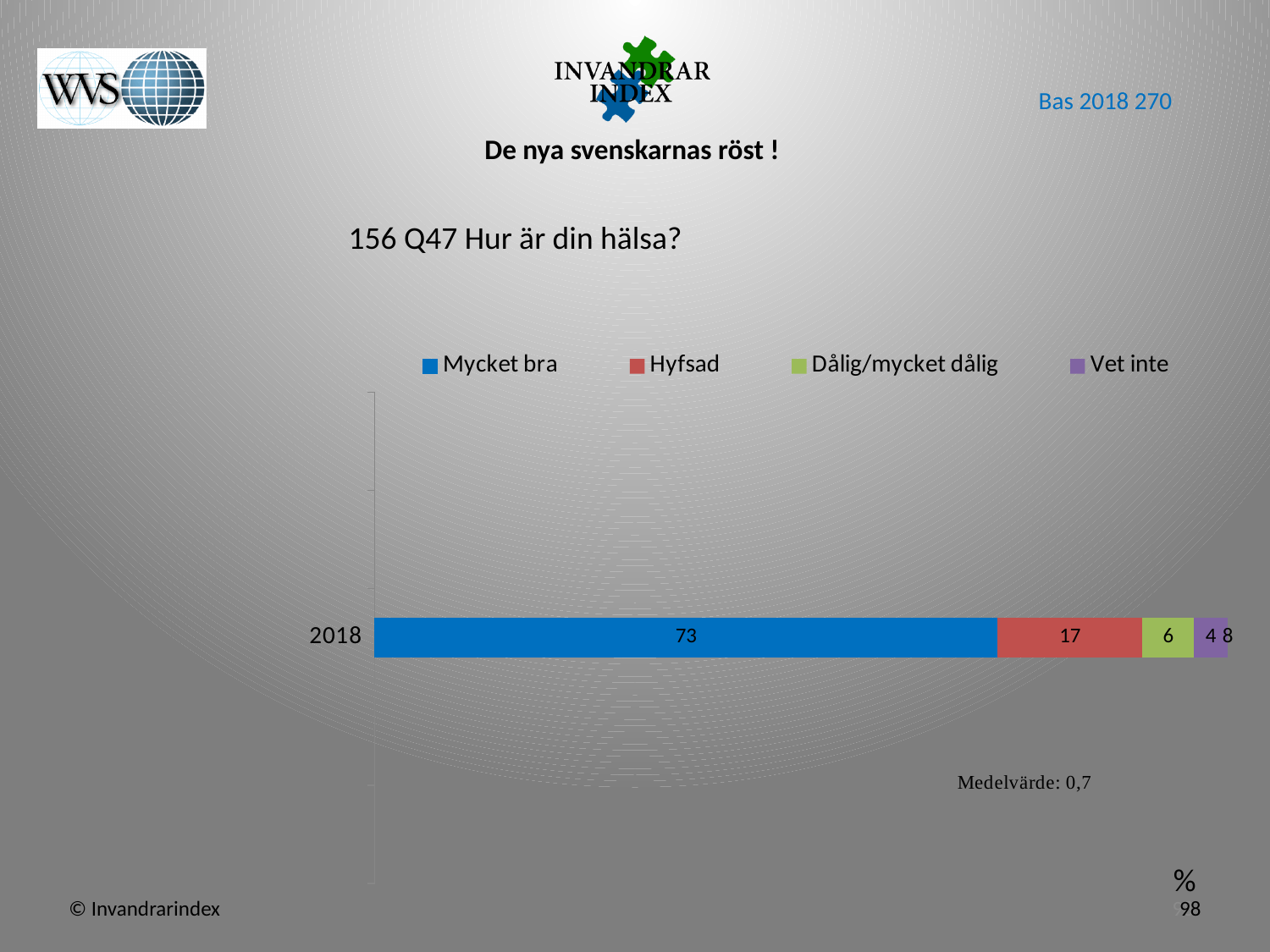
How many series does the legend list? 4 What kind of chart is shown on the slide? Stacked bar chart Which series has the lowest value in the 2018 bar? Vet inte What is the value for Hyfsad in 2018? 17 Which is larger in 2018, Hyfsad or Dålig/mycket dålig? Hyfsad What is the difference between the Mycket bra and Hyfsad values in 2018? 56 How many categories are shown on the category axis? 1 What is the value for Vet inte in 2018? 4 What is the question title shown above the chart? 156 Q47 Hur är din hälsa? Which series has the highest value in the 2018 bar? Mycket bra What is the value for Dålig/mycket dålig in 2018? 6 What is the value for Mycket bra in 2018? 73